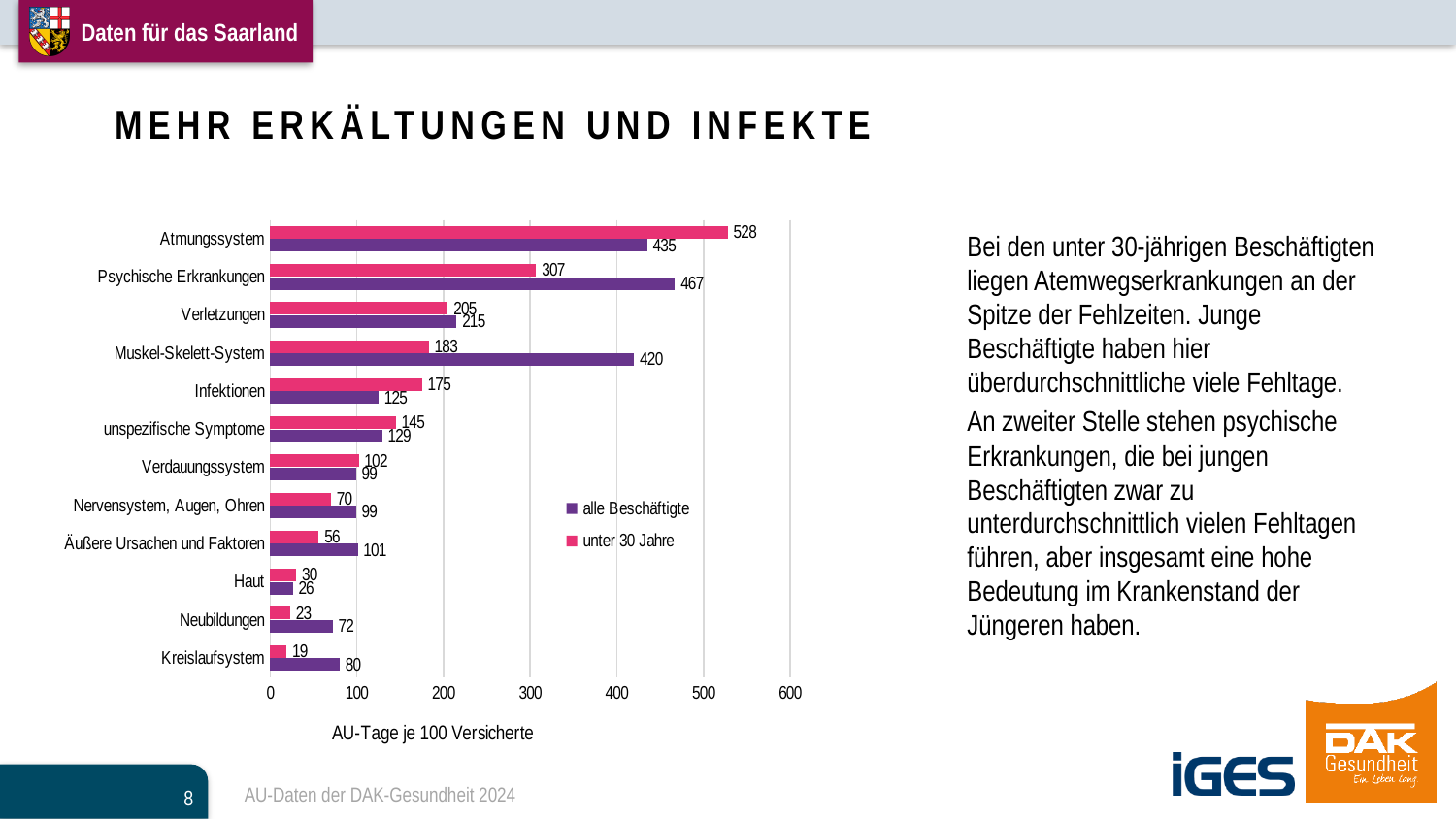
How many categories are shown on the chart? 12 Which category has the lowest value in the 'unter 30 Jahre' series? Kreislaufsystem Is the 'alle Beschäftigte' value for Psychische Erkrankungen greater or less than 400? greater What is the value for Psychische Erkrankungen in the 'alle Beschäftigte' series? 467 What is the value for Muskel-Skelett-System in the 'unter 30 Jahre' series? 183 What is the difference between the 'unter 30 Jahre' and 'alle Beschäftigte' values for Atmungssystem? 93 For Muskel-Skelett-System, which series has the larger value: 'alle Beschäftigte' or 'unter 30 Jahre'? alle Beschäftigte What is the value for Atmungssystem in the 'unter 30 Jahre' series? 528 How many series does the legend list? 2 Which category has the highest value in the 'alle Beschäftigte' series? Psychische Erkrankungen What type of chart is shown on the slide? Bar chart What is the label of the x axis of the chart? AU-Tage je 100 Versicherte